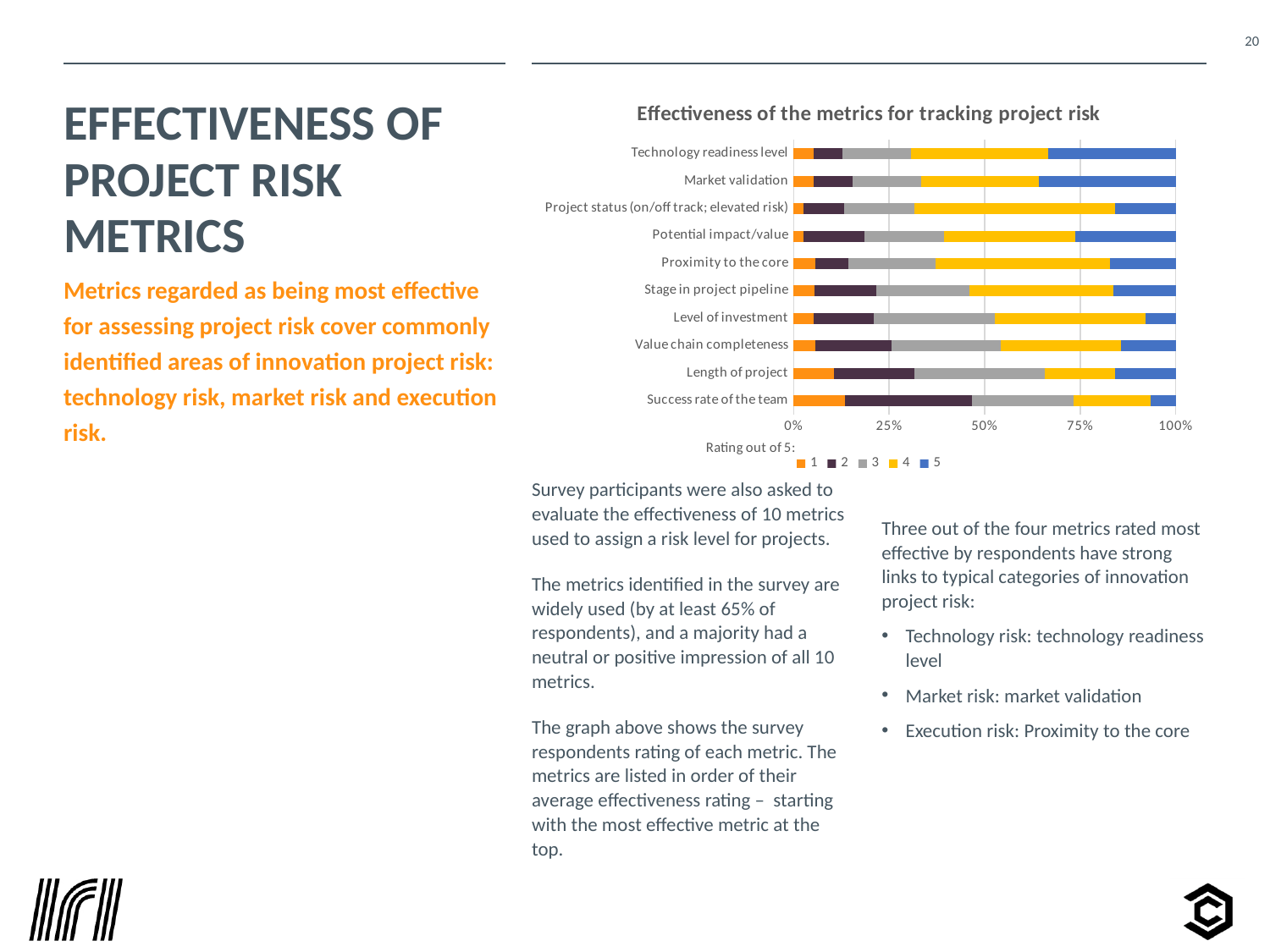
What is the title of the chart? Effectiveness of the metrics for tracking project risk How many series does the chart legend list? 5 Which has the larger share of respondents giving a rating of 1: Success rate of the team or Technology readiness level? Success rate of the team Is the share of respondents giving a rating of 5 to Success rate of the team greater or less than 25%? less Is the share of respondents giving a rating of 1 to Length of project greater or less than 25%? less Is the share of respondents giving a rating of 5 to Technology readiness level greater or less than 25%? greater How many metrics (categories) are plotted in the chart? 10 Which metric is listed at the top of the chart? Technology readiness level Which has the larger share of respondents giving a rating of 5: Technology readiness level or Success rate of the team? Technology readiness level What kind of chart is shown on the slide? Stacked bar chart Which metric has the largest share of respondents giving a rating of 2? Success rate of the team